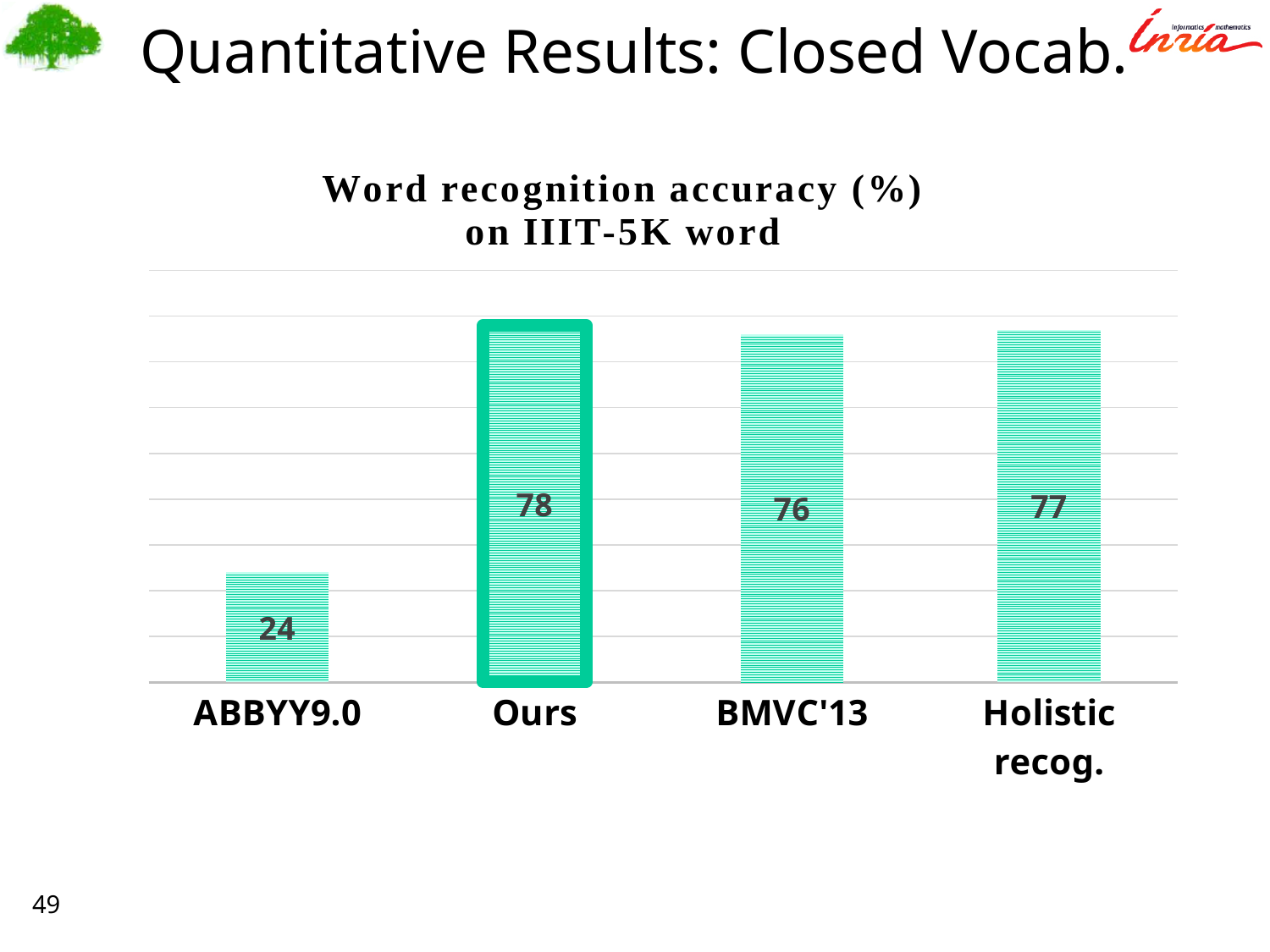
What kind of chart is shown on the slide? Bar chart What is the word recognition accuracy for BMVC'13? 76 What is the difference in accuracy between Ours and ABBYY9.0? 54 Which method has the lowest word recognition accuracy? ABBYY9.0 What is the title of the chart? Word recognition accuracy (%) on IIIT-5K word What is the difference in accuracy between Ours and BMVC'13? 2 What is the word recognition accuracy for Ours? 78 Which method has the highest word recognition accuracy? Ours What is the word recognition accuracy for Holistic recog.? 77 What is the word recognition accuracy for ABBYY9.0? 24 How many methods are compared in the chart? 4 Which has a higher accuracy, ABBYY9.0 or Holistic recog.? Holistic recog.